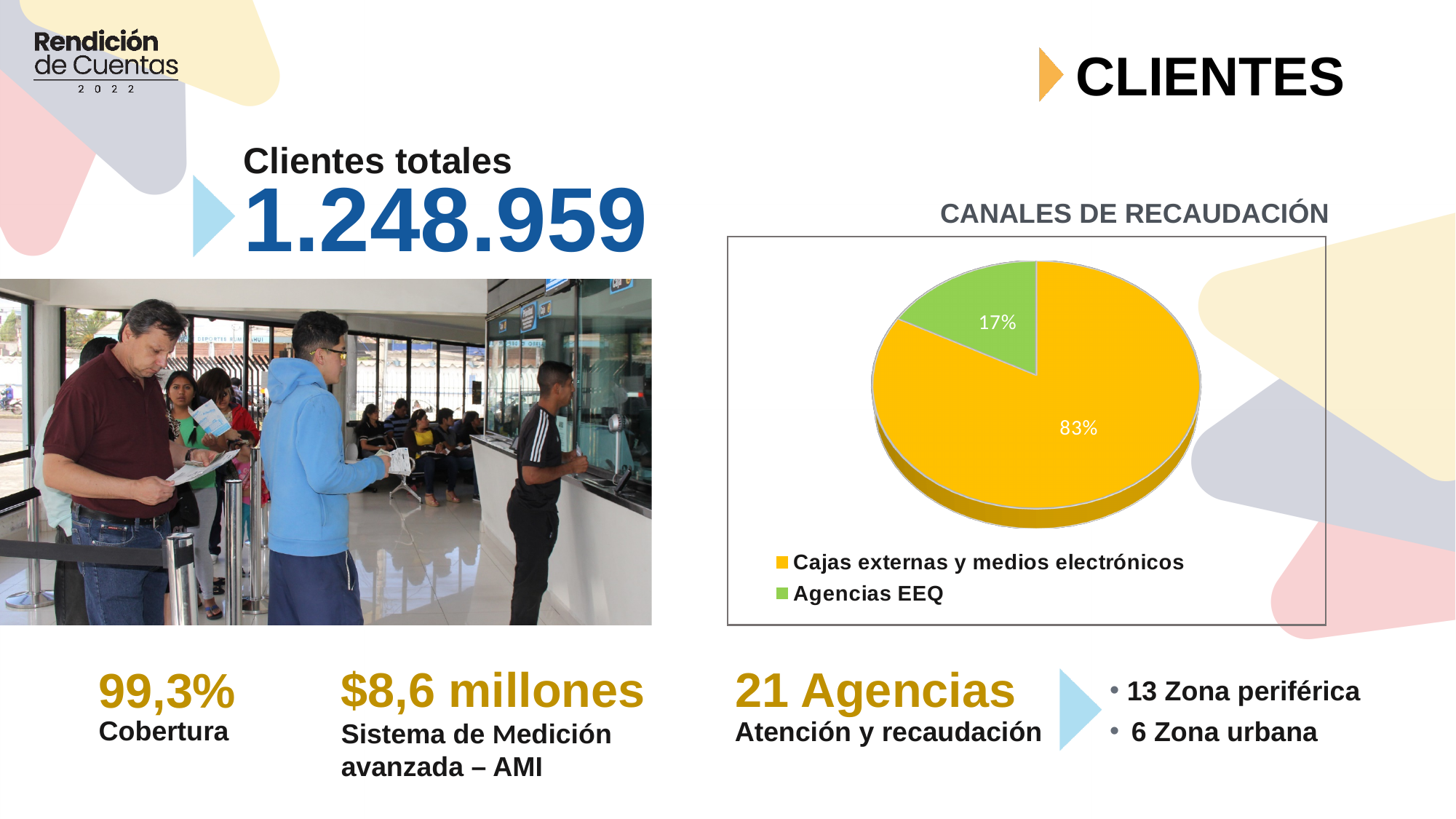
Which category has the smallest slice of the pie? Agencias EEQ What share of the pie does Cajas externas y medios electrónicos represent? 83% What is the difference in percentage points between Cajas externas y medios electrónicos and Agencias EEQ? 66 What share of the pie does Agencias EEQ represent? 17% What is the title of the chart on the slide? CANALES DE RECAUDACIÓN What type of chart is shown under the title CANALES DE RECAUDACIÓN? Pie chart Which is larger, the slice for Agencias EEQ or the slice for Cajas externas y medios electrónicos? Cajas externas y medios electrónicos Which category has the largest slice of the pie? Cajas externas y medios electrónicos What colour is the slice for Agencias EEQ? Green How many entries does the legend of the pie chart list? 2 How many categories does the pie chart show? 2